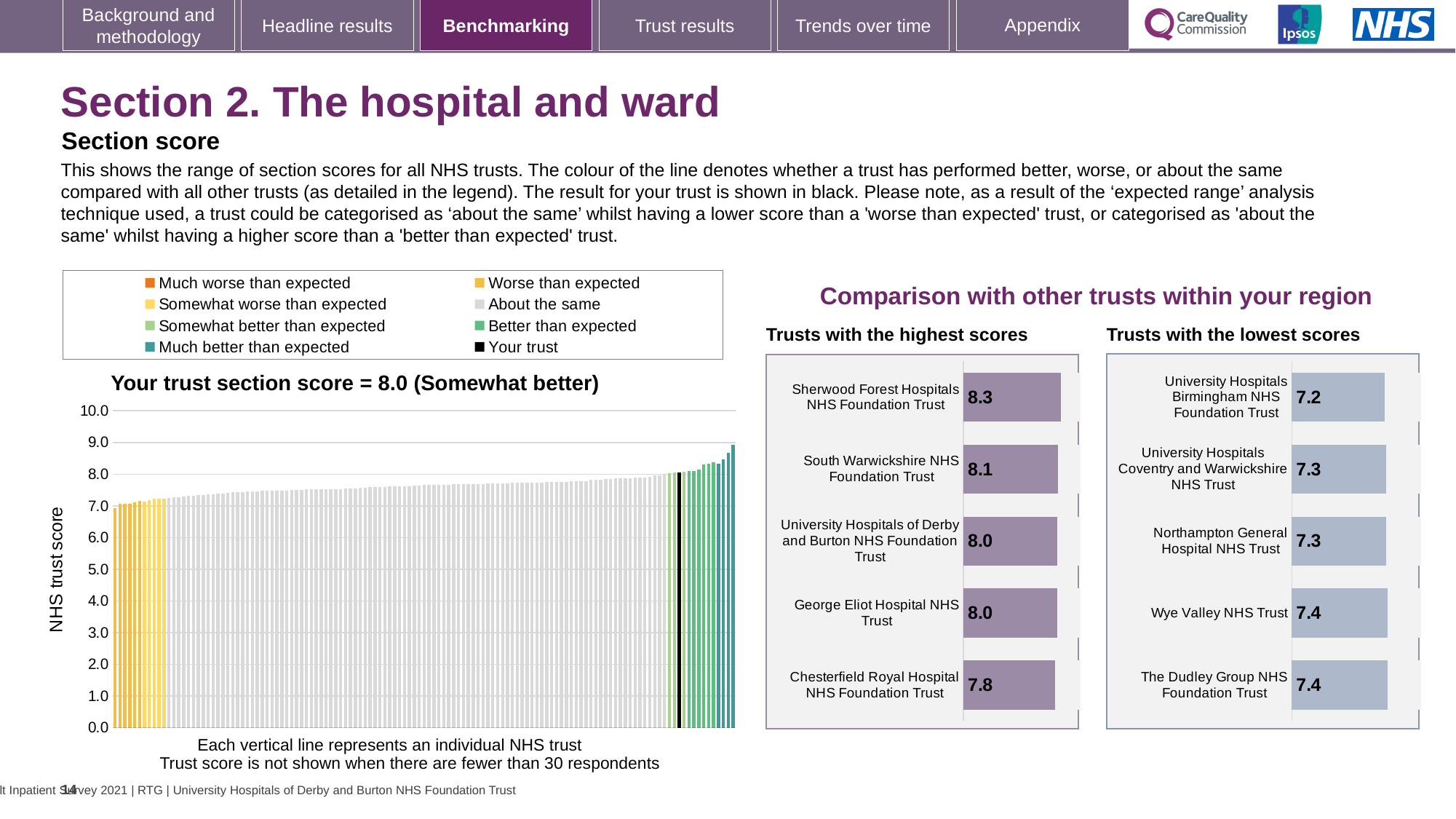
In the 'Your trust section score' chart, do the trust scores rise or fall from left to right along the x axis? rise In the 'Trusts with the lowest scores' chart, what is the score for Wye Valley NHS Trust? 7.4 In the 'Trusts with the highest scores' chart, which trust has the highest score? Sherwood Forest Hospitals NHS Foundation Trust According to the title of the chart on the left, what is your trust's section score? 8.0 How many trusts are shown in the 'Trusts with the highest scores' chart? 5 In the 'Trusts with the lowest scores' chart, what is the difference between the scores of The Dudley Group NHS Foundation Trust and University Hospitals Birmingham NHS Foundation Trust? 0.2 In the 'Trusts with the lowest scores' chart, which trust has the lowest score? University Hospitals Birmingham NHS Foundation Trust What kind of chart is the 'Your trust section score' chart on the left of the slide? bar chart In the 'Trusts with the highest scores' chart, what is the difference between the scores of Sherwood Forest Hospitals NHS Foundation Trust and Chesterfield Royal Hospital NHS Foundation Trust? 0.5 In the 'Trusts with the highest scores' chart, which has the larger score: South Warwickshire NHS Foundation Trust or George Eliot Hospital NHS Trust? South Warwickshire NHS Foundation Trust In the 'Trusts with the highest scores' chart, what is the score for Sherwood Forest Hospitals NHS Foundation Trust? 8.3 In the legend of the chart on the left, what colour represents 'Your trust'? black